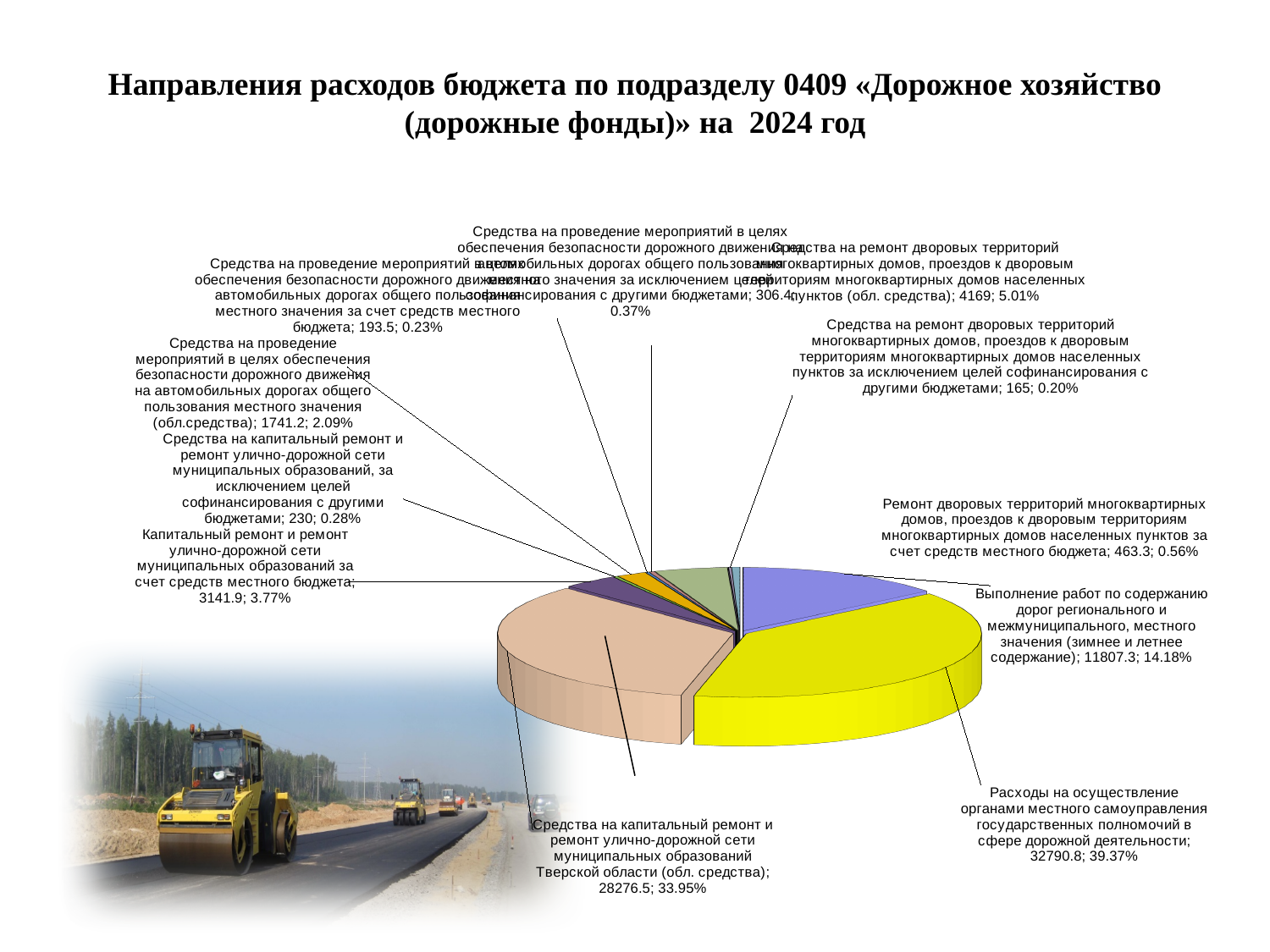
What is the difference between the value for "Расходы на осуществление органами местного самоуправления государственных полномочий в сфере дорожной деятельности" (32790.8) and "Средства на капитальный ремонт и ремонт улично-дорожной сети муниципальных образований Тверской области (обл. средства)" (28276.5)? 4514.3 What kind of chart is shown on the slide? pie chart What is the title of the slide? Направления расходов бюджета по подразделу 0409 «Дорожное хозяйство (дорожные фонды)» на 2024 год What is the value for "Выполнение работ по содержанию дорог регионального и межмуниципального, местного значения (зимнее и летнее содержание)"? 11807.3 What percentage is shown for "Капитальный ремонт и ремонт улично-дорожной сети муниципальных образований за счет средств местного бюджета"? 3.77% Which category has the largest share of the pie? Расходы на осуществление органами местного самоуправления государственных полномочий в сфере дорожной деятельности How many categories (slices) does the pie chart have? 11 Which is larger: the value for "Ремонт дворовых территорий ... за счет средств местного бюджета" (463.3) or "Средства на ремонт дворовых территорий ... (обл. средства)" (4169)? Средства на ремонт дворовых территорий ... (обл. средства) What is the value for "Средства на проведение мероприятий в целях обеспечения безопасности дорожного движения на автомобильных дорогах общего пользования местного значения (обл.средства)"? 1741.2 What is the value for "Расходы на осуществление органами местного самоуправления государственных полномочий в сфере дорожной деятельности"? 32790.8 What share of the pie does "Средства на капитальный ремонт и ремонт улично-дорожной сети муниципальных образований Тверской области (обл. средства)" represent? 33.95% Which category has the smallest share of the pie? Средства на ремонт дворовых территорий многоквартирных домов, проездов к дворовым территориям многоквартирных домов населенных пунктов за исключением целей софинансирования с другими бюджетами